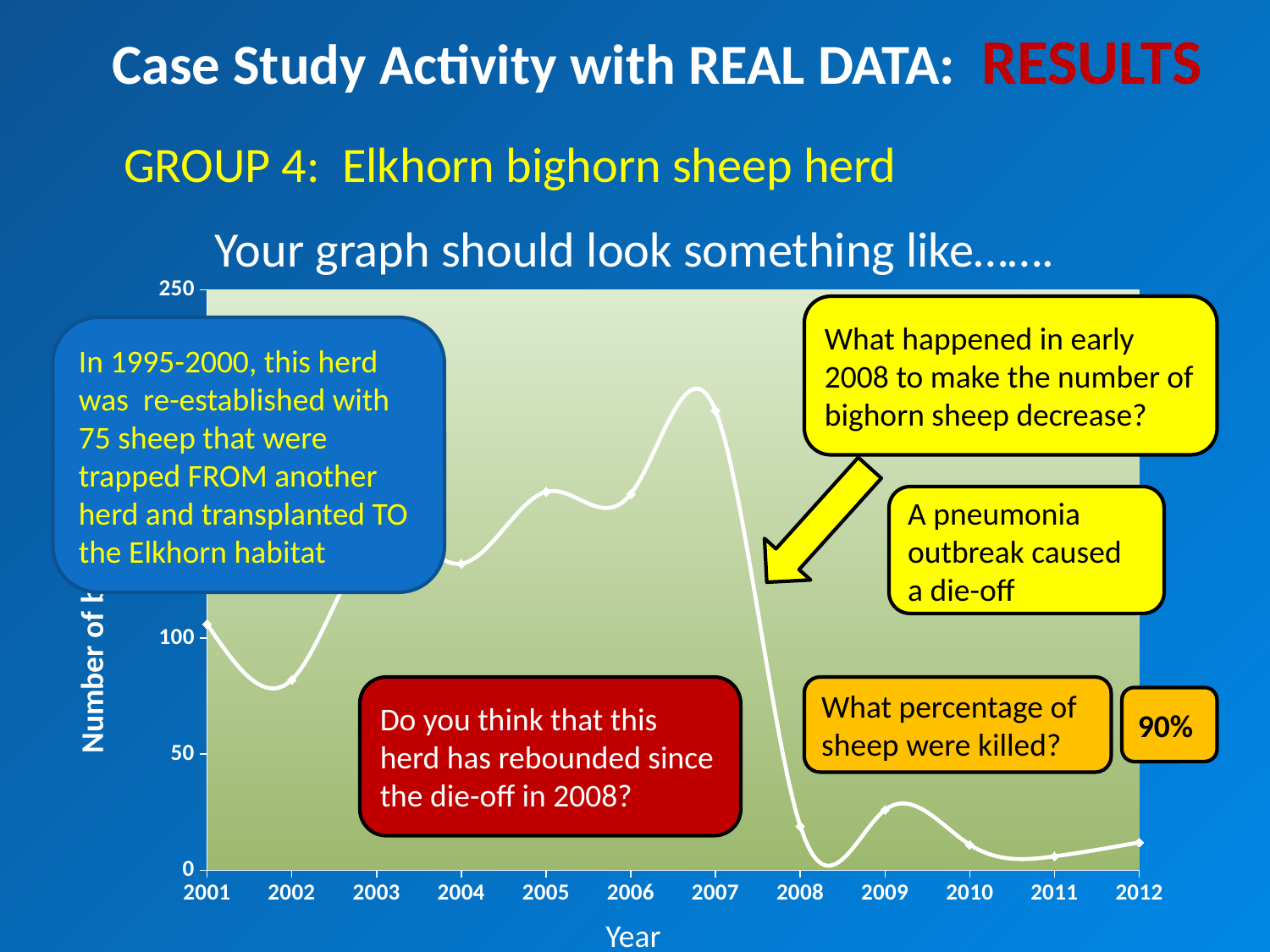
What is the label on the x axis of the chart? Year How many years are plotted along the x axis of the chart? 12 Is the value for 2002 greater or less than 100? less Is the value for 2011 greater or less than 50? less Is the value for 2008 greater or less than 50? less What kind of chart is shown on the slide? line chart Which is larger, the value for 2004 or the value for 2010? 2004 Which is larger, the value for 2007 or the value for 2008? 2007 Which year has the highest value on the chart? 2007 Do the values rise or fall from 2004 to 2007? rise